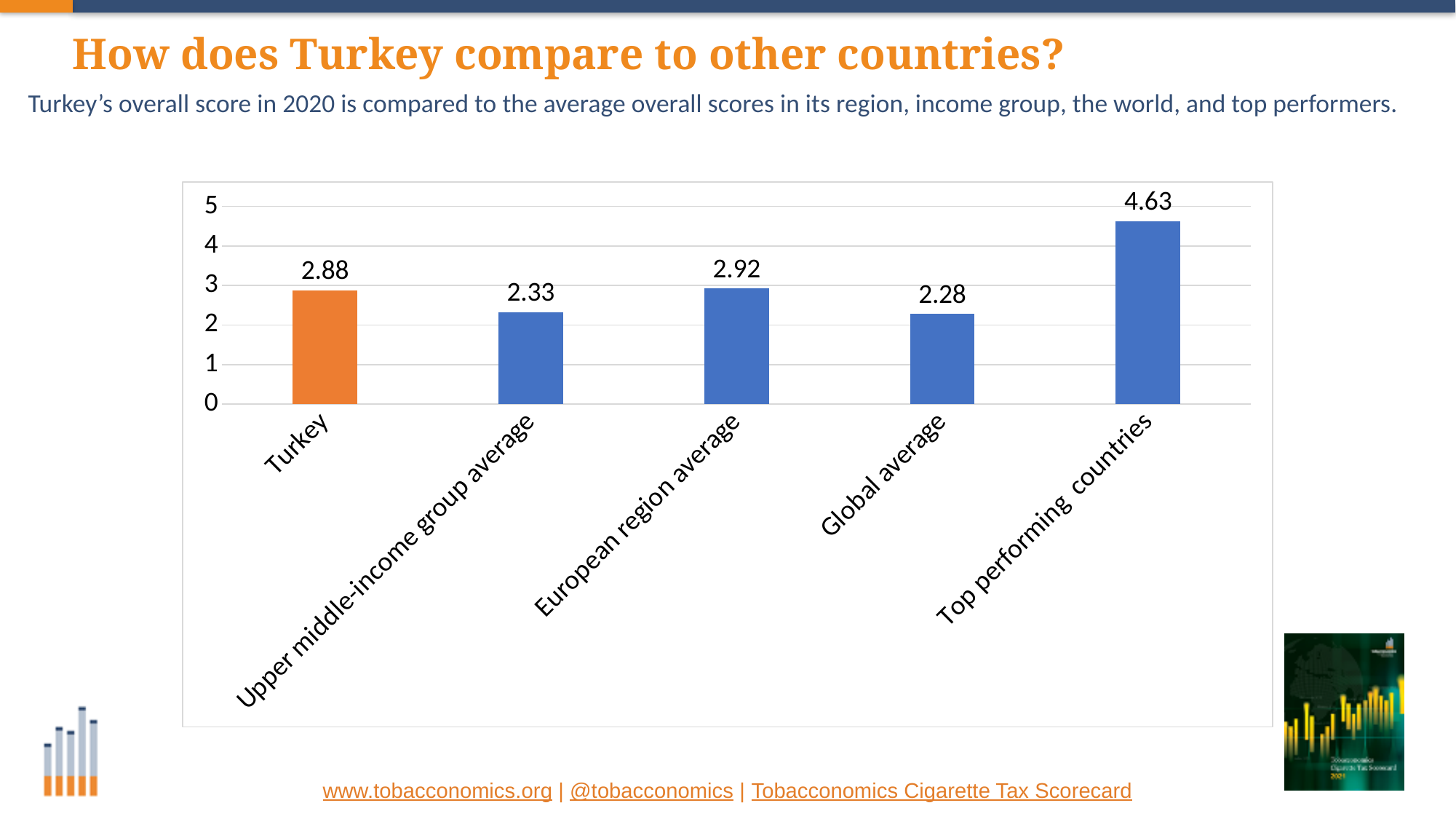
Which category has the lowest value? Global average What is the overall score for Turkey? 2.88 Which category has the highest value? Top performing countries How many categories are shown in the chart? 5 What is the value for the Global average? 2.28 What is the difference between Turkey's value and the Global average? 0.6 What is the value for the Upper middle-income group average? 2.33 What is the difference between the Top performing countries value and Turkey's value? 1.75 What kind of chart is shown on the slide? Bar chart What is the value for Top performing countries? 4.63 What is the value for the European region average? 2.92 Which is larger, Turkey's value or the Upper middle-income group average? Turkey